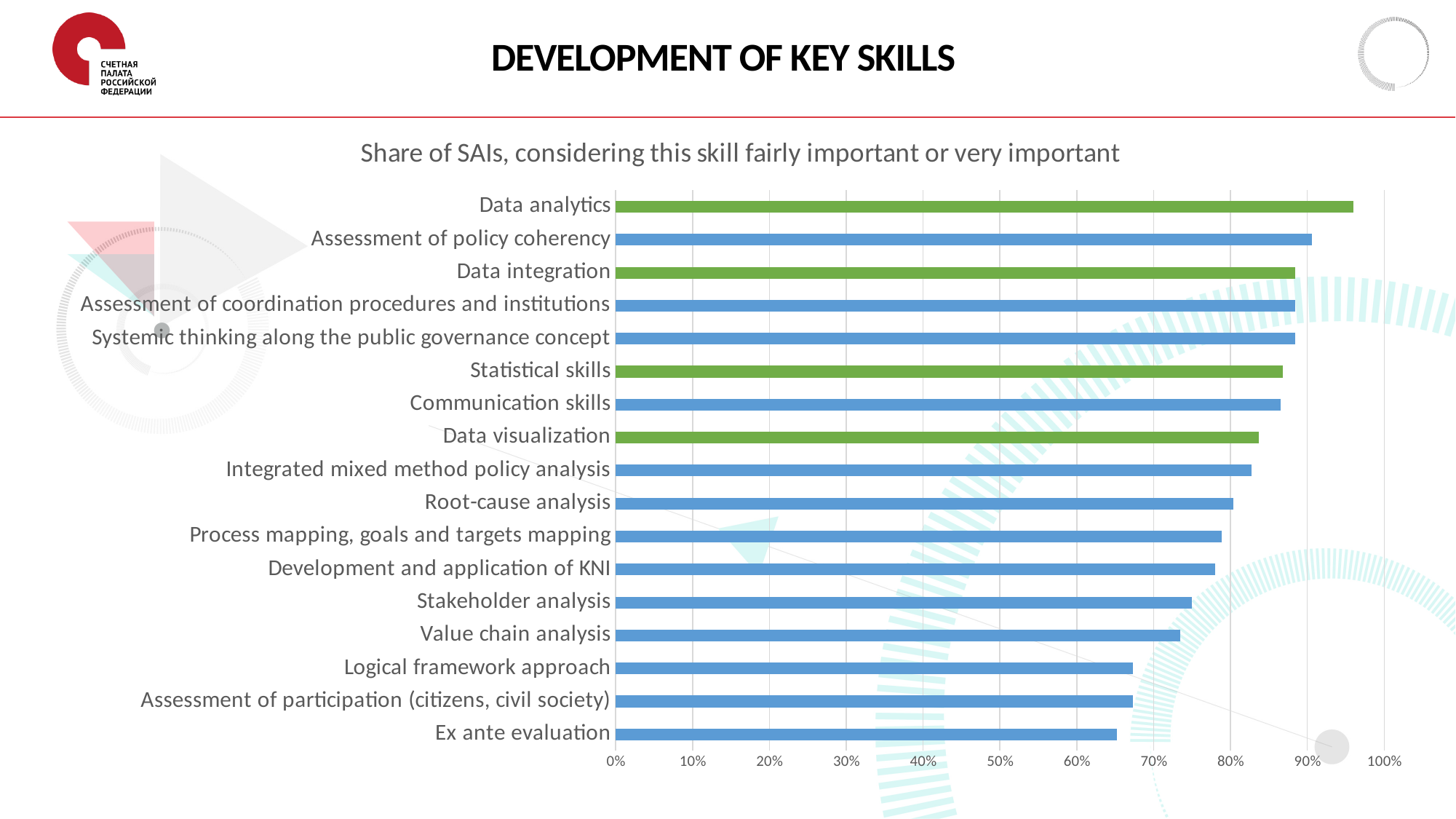
How many skills (categories) are plotted in the chart? 17 Which skill has the highest share of SAIs considering it fairly or very important? Data analytics Is the value for Ex ante evaluation greater or less than 70%? less What kind of chart is shown on the slide? bar chart Which skill has the lowest share of SAIs considering it fairly or very important? Ex ante evaluation How many bars in the chart are coloured green? 4 Is the value for Data visualization greater or less than 80%? greater Do the bar values rise or fall going from the top of the chart to the bottom? fall What is the title of the chart? Share of SAIs, considering this skill fairly important or very important Which has a larger value: Statistical skills or Stakeholder analysis? Statistical skills Is the value for Value chain analysis greater or less than 80%? less